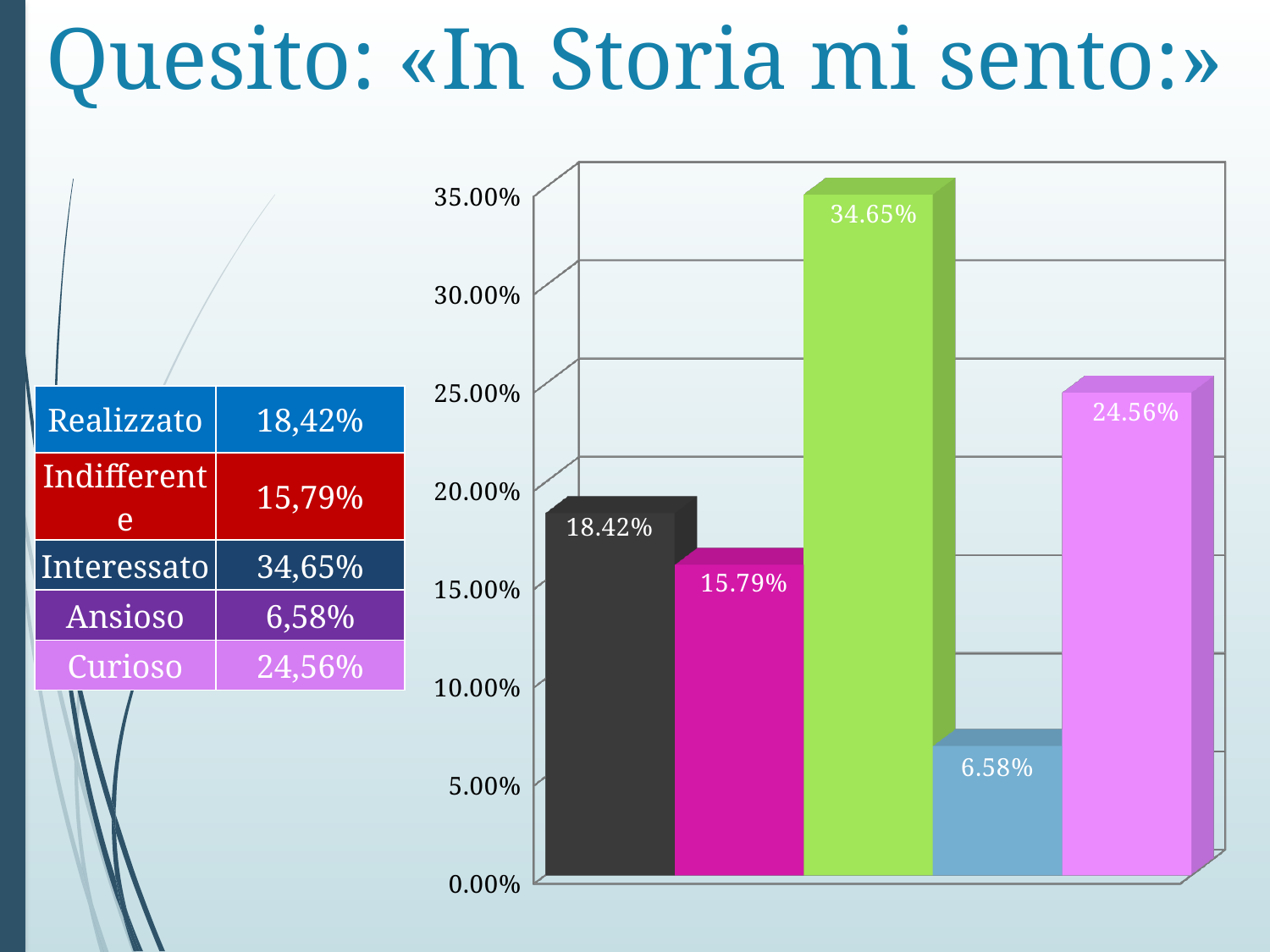
What is the value shown on the tallest bar of the chart? 34.65% What type of chart is shown on the slide? bar chart What is the difference between the tallest bar (34.65%) and the rightmost bar (24.56%)? 10.09% How many bars does the chart contain? 5 What value is labelled on the last (rightmost) bar of the chart? 24.56% What is the value shown on the shortest bar of the chart? 6.58% What value is labelled on the first (leftmost) bar of the chart? 18.42% Which is larger, the value of the first bar (18.42%) or the second bar (15.79%)? the first bar (18.42%) According to the slide, which category has the lowest value? Ansioso According to the slide, which category has the highest value? Interessato What is the highest value shown on the vertical axis of the chart? 35.00% What value is labelled on the second bar of the chart? 15.79%